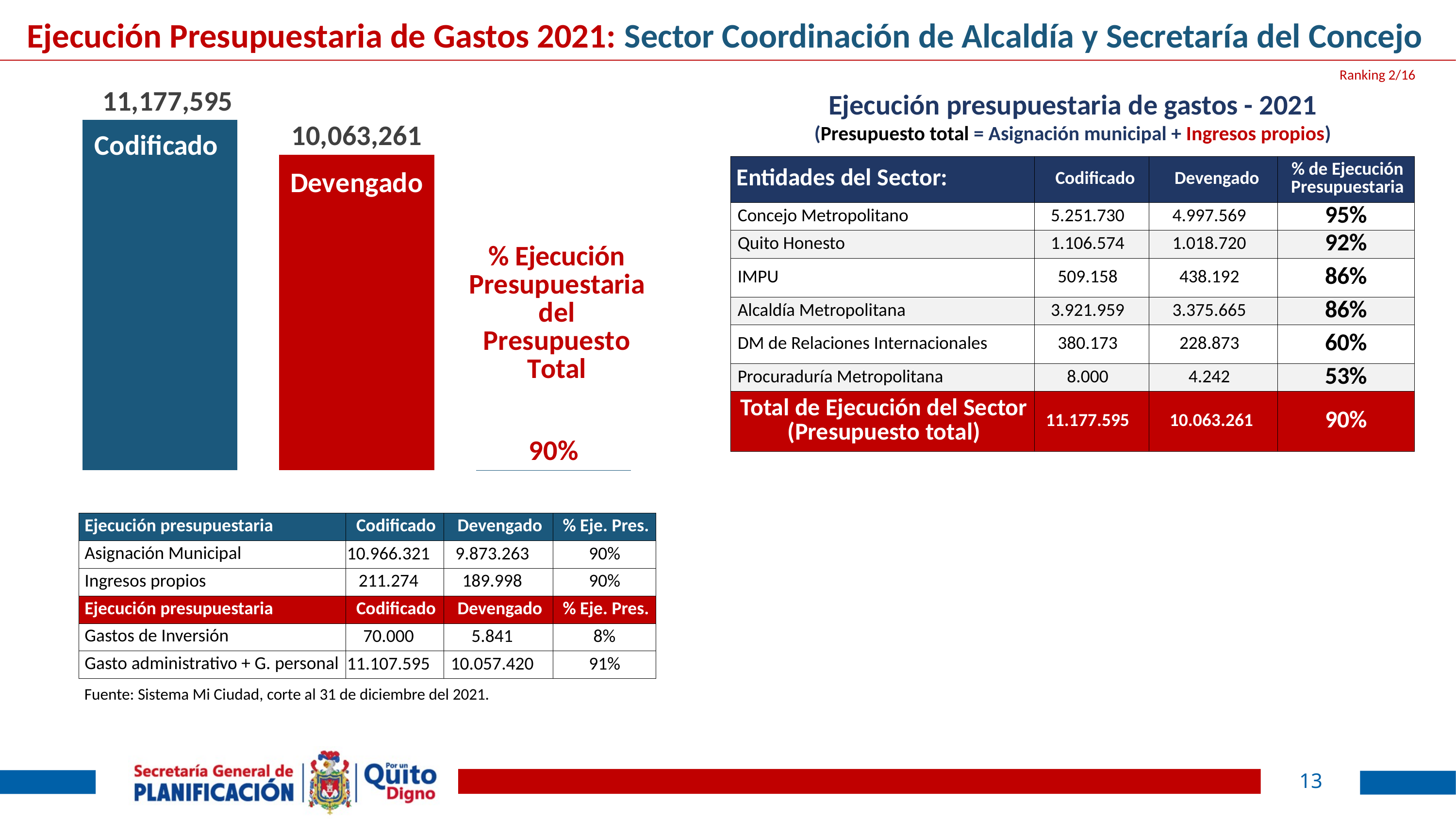
What type of chart is shown on the left of the slide? Bar chart Which bar in the chart has the lowest value? Devengado Is the value of the Devengado bar greater or less than 11,000,000? less How many bars are plotted in the bar chart? 2 What is the difference between the Codificado and Devengado values shown in the bar chart? 1,114,334 What colour is the Devengado bar in the chart? Red What percentage is shown next to the bars as the % Ejecución Presupuestaria del Presupuesto Total? 90% What is the value of the Codificado bar in the bar chart? 11,177,595 Which bar in the chart is taller, Codificado or Devengado? Codificado What is the value of the Devengado bar in the bar chart? 10,063,261 What colour is the Codificado bar in the chart? Blue Which bar in the chart has the highest value? Codificado